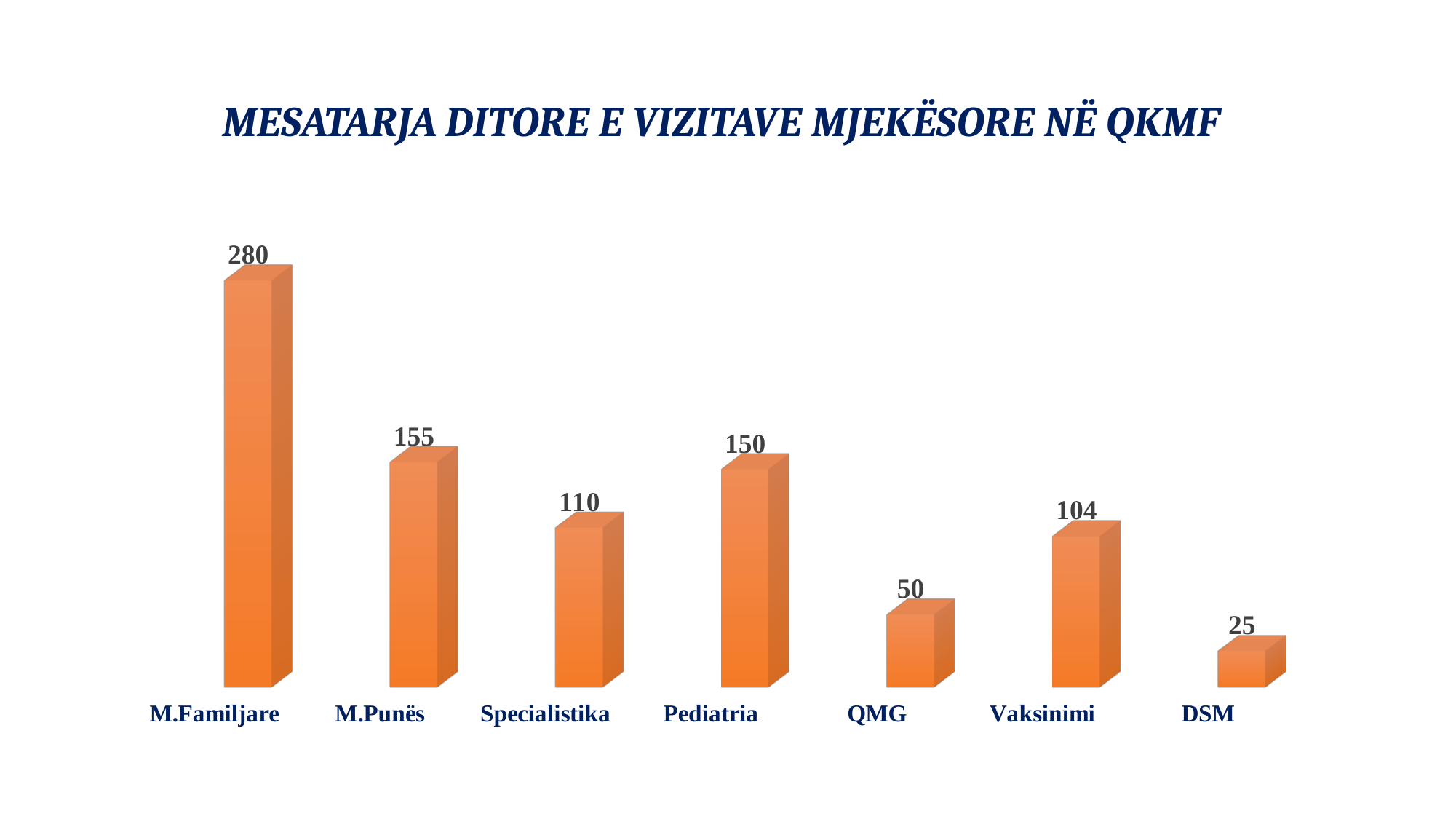
What is the difference between the values for M.Familjare and M.Punës? 125 What is the value for Pediatria? 150 Which category has the highest value? M.Familjare What is the value for M.Familjare? 280 What is the difference between the values for Specialistika and QMG? 60 Which category has the lowest value? DSM Which is larger, the value for M.Punës or the value for Pediatria? M.Punës How many categories are shown in the chart? 7 What is the value for Vaksinimi? 104 What kind of chart is shown on the slide? Bar chart What is the value for DSM? 25 What is the title of the chart? MESATARJA DITORE E VIZITAVE MJEKËSORE NË QKMF